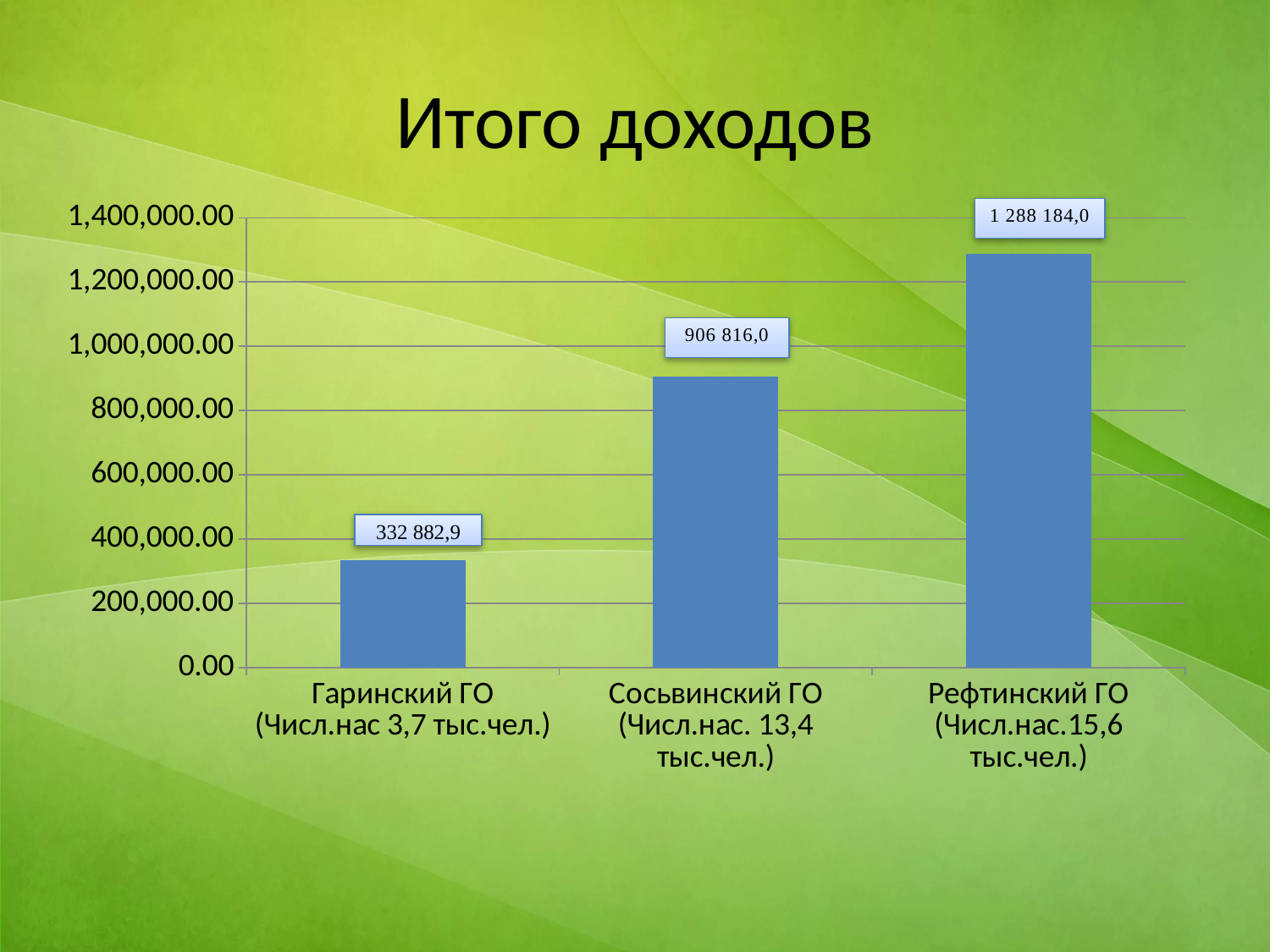
What type of chart is shown on the slide? bar chart What is the difference between the values for Сосьвинский ГО and Гаринский ГО? 573 933,1 Which category has the lowest value? Гаринский ГО What is the title of the chart? Итого доходов What is the value for Гаринский ГО? 332 882,9 What is the value for Сосьвинский ГО? 906 816,0 Which is larger, the value for Сосьвинский ГО or the value for Гаринский ГО? Сосьвинский ГО Which category has the highest value? Рефтинский ГО How many categories are plotted in the chart? 3 Do the values rise or fall from left to right along the x axis? rise What is the difference between the values for Рефтинский ГО and Сосьвинский ГО? 381 368,0 What is the value for Рефтинский ГО? 1 288 184,0